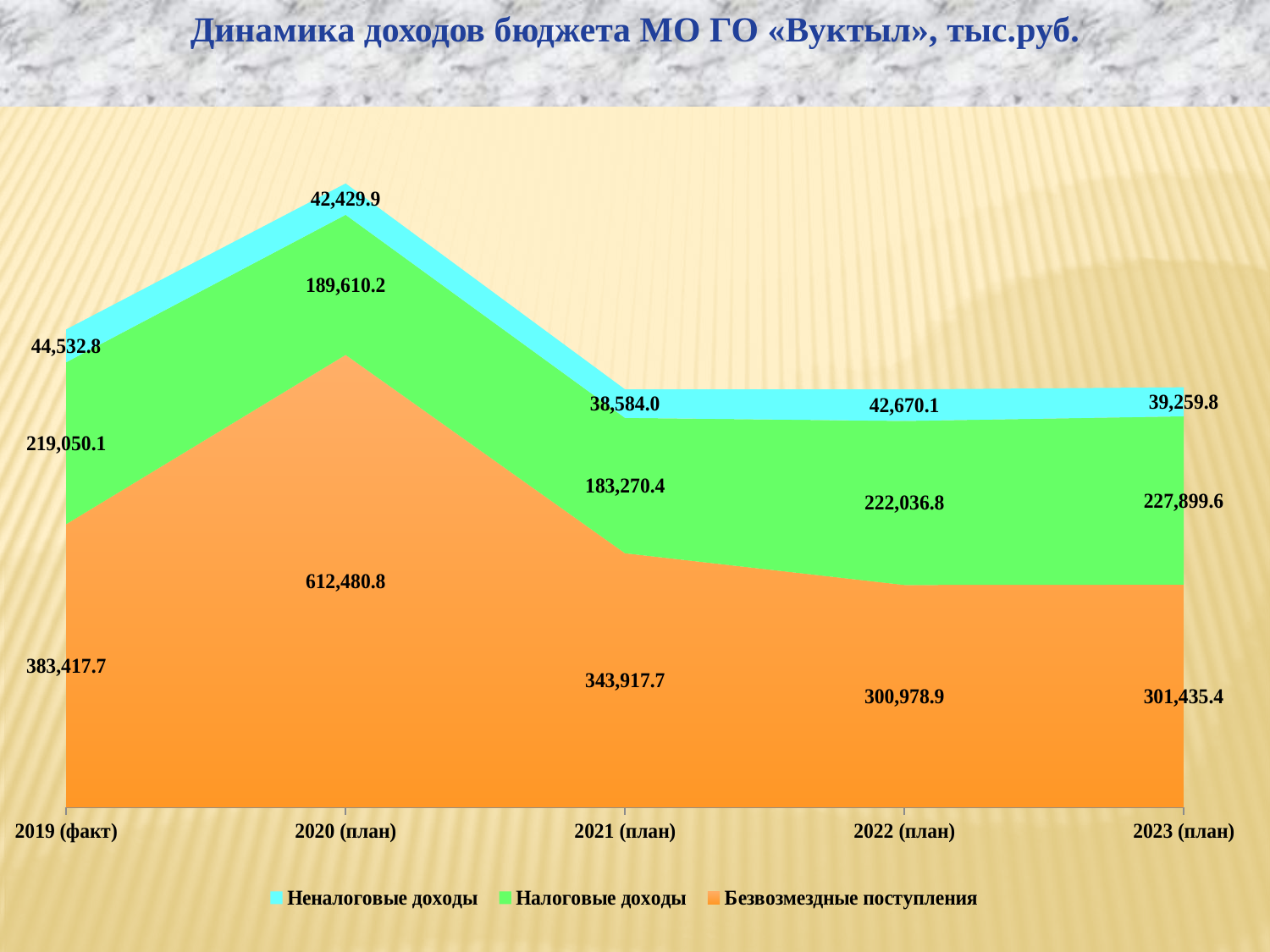
What is the difference between Налоговые доходы in 2023 (план) and 2022 (план)? 5,862.8 How many years are shown on the x axis? 5 In which year is Безвозмездные поступления highest? 2020 (план) What is the value of Безвозмездные поступления for 2020 (план)? 612,480.8 Which is larger: Безвозмездные поступления in 2019 (факт) or in 2021 (план)? 2019 (факт) What is the title of the chart? Динамика доходов бюджета МО ГО «Вуктыл», тыс.руб. What is the value of Налоговые доходы for 2023 (план)? 227,899.6 In which year is Неналоговые доходы lowest? 2021 (план) What is the value of Неналоговые доходы for 2021 (план)? 38,584.0 How many series does the legend list? 3 What kind of chart is this? Stacked area chart What is the total of all three series for 2020 (план)? 844,520.9